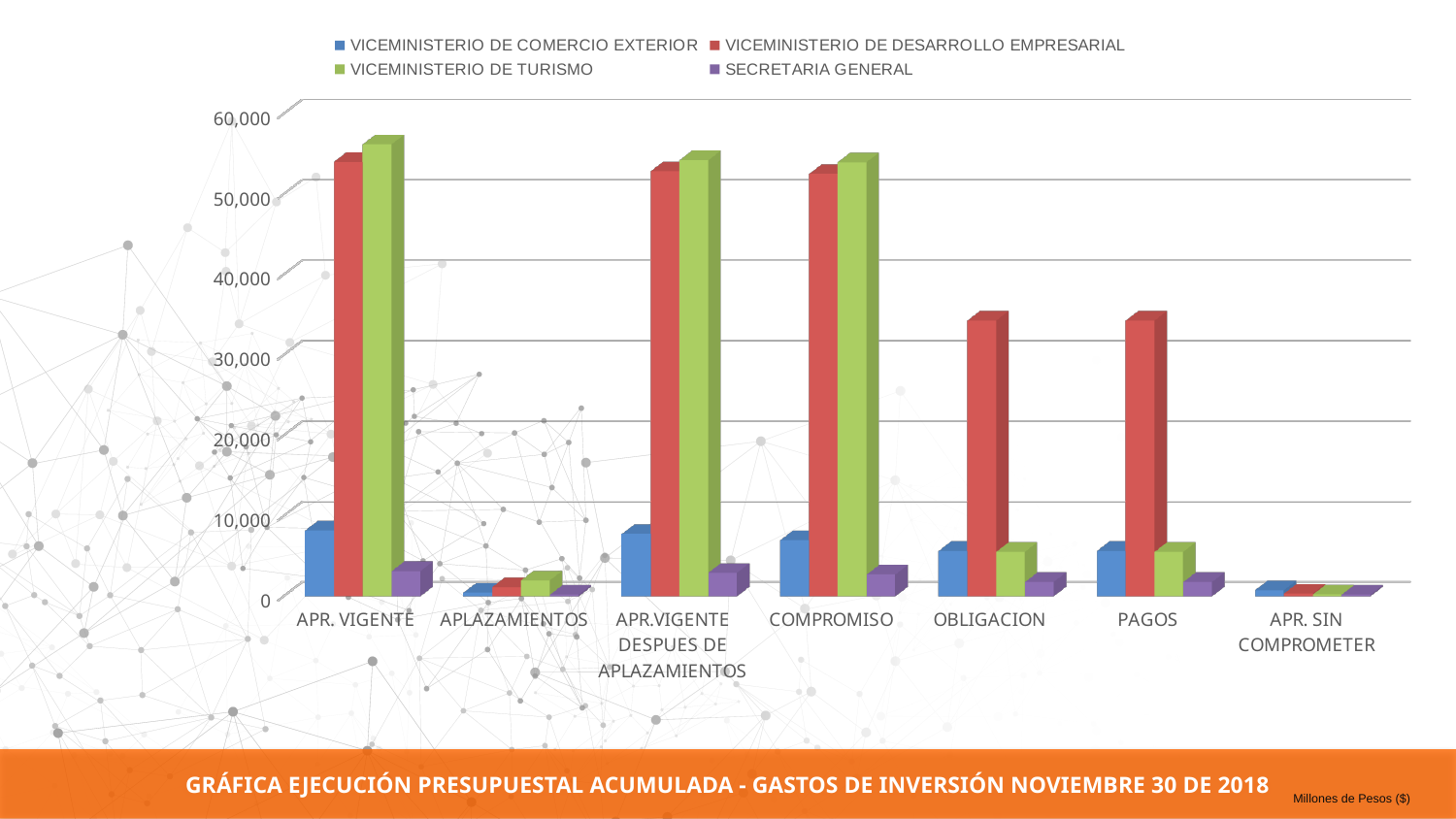
Is the value for VICEMINISTERIO DE TURISMO in APR. VIGENTE greater or less than 50,000? greater Which series has the lowest value in the OBLIGACION category? SECRETARIA GENERAL What unit is indicated for the values in the chart? Millones de Pesos ($) In OBLIGACION, which is larger: VICEMINISTERIO DE DESARROLLO EMPRESARIAL or VICEMINISTERIO DE TURISMO? VICEMINISTERIO DE DESARROLLO EMPRESARIAL What is the title of the chart? GRÁFICA EJECUCIÓN PRESUPUESTAL ACUMULADA - GASTOS DE INVERSIÓN NOVIEMBRE 30 DE 2018 Is the value for VICEMINISTERIO DE DESARROLLO EMPRESARIAL in OBLIGACION greater or less than 30,000? greater How many categories are shown along the x axis? 7 Is the value for VICEMINISTERIO DE COMERCIO EXTERIOR in COMPROMISO greater or less than 10,000? less How many series does the legend list? 4 What kind of chart is shown on the slide? Bar chart In APR. VIGENTE, which is larger: VICEMINISTERIO DE TURISMO or VICEMINISTERIO DE COMERCIO EXTERIOR? VICEMINISTERIO DE TURISMO